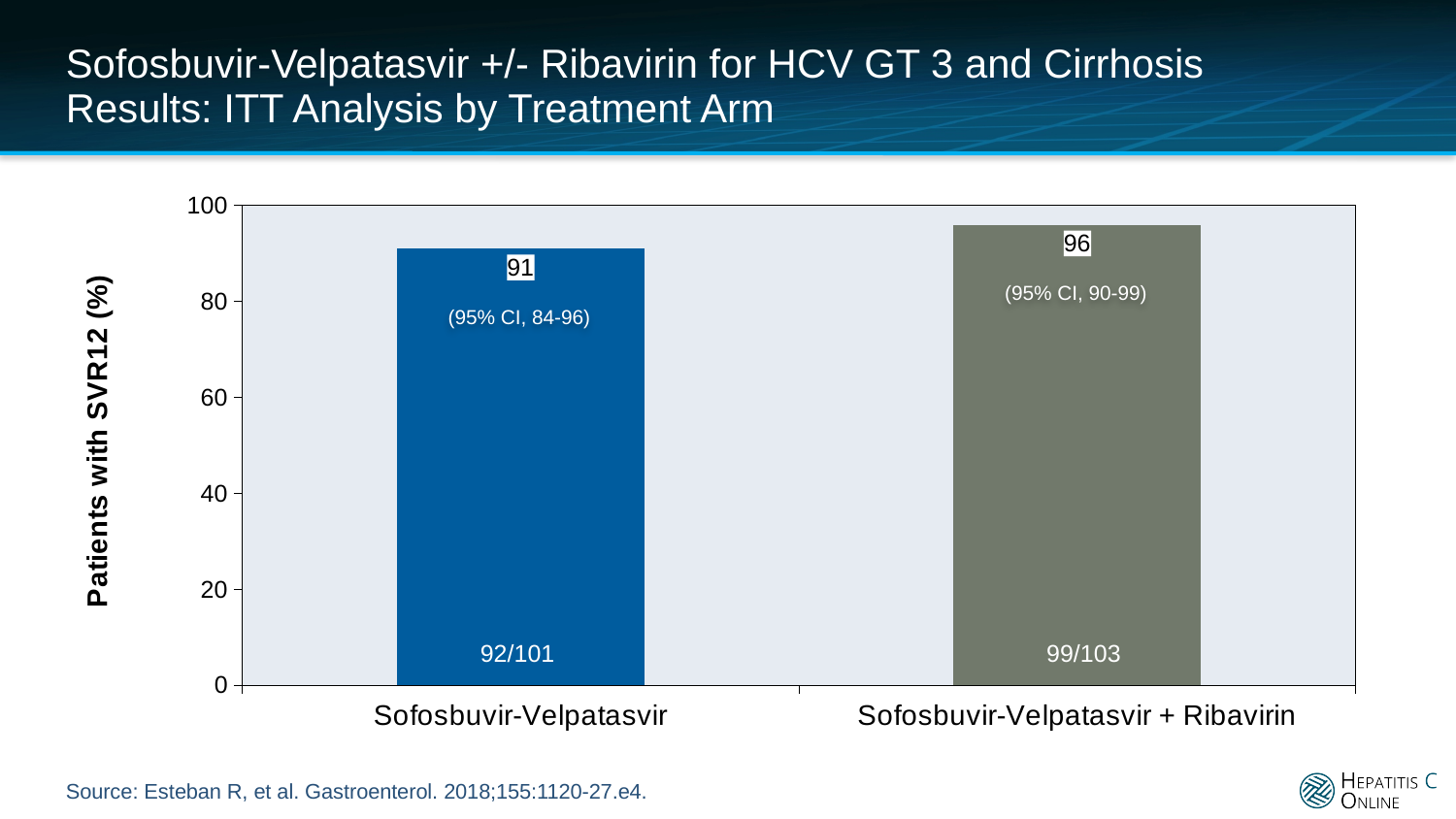
What is the SVR12 rate for the Sofosbuvir-Velpatasvir arm? 91 What is the difference in SVR12 rate between the Sofosbuvir-Velpatasvir + Ribavirin arm and the Sofosbuvir-Velpatasvir arm? 5 How many treatment arms are shown in the chart? 2 What kind of chart is shown on the slide? Bar chart What is the label of the y-axis? Patients with SVR12 (%) What is the SVR12 rate for the Sofosbuvir-Velpatasvir + Ribavirin arm? 96 What is the 95% confidence interval shown for the Sofosbuvir-Velpatasvir arm? 84-96 Which treatment arm has the lower SVR12 rate? Sofosbuvir-Velpatasvir Which treatment arm has the higher SVR12 rate? Sofosbuvir-Velpatasvir + Ribavirin Is the SVR12 rate for Sofosbuvir-Velpatasvir greater or less than 80? greater What is the 95% confidence interval shown for the Sofosbuvir-Velpatasvir + Ribavirin arm? 90-99 How many patients achieved SVR12 out of the total in the Sofosbuvir-Velpatasvir + Ribavirin arm? 99/103